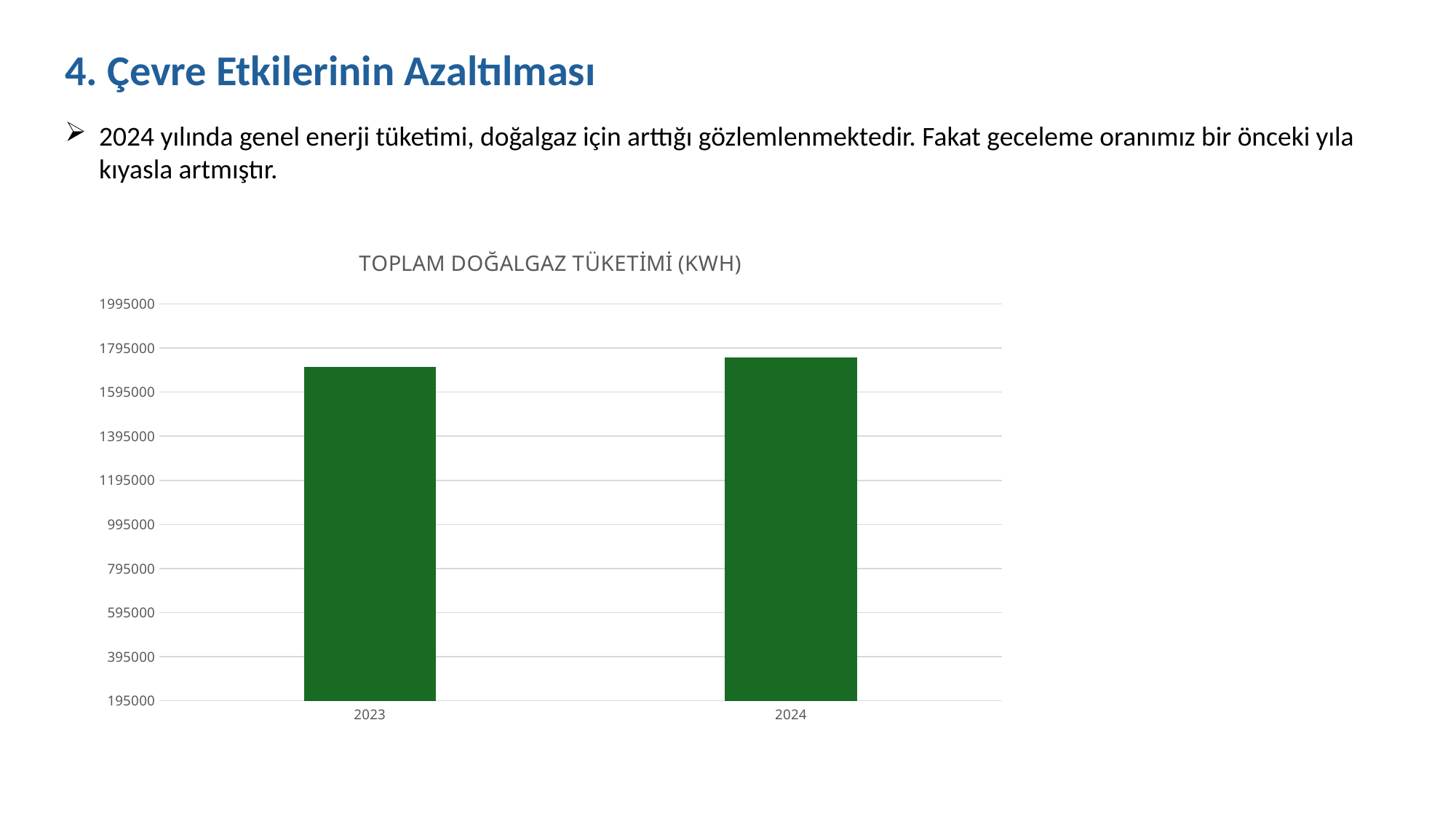
What type of chart is shown on the slide? bar chart How many categories (years) are shown on the x axis of the chart? 2 Is the value for 2023 greater or less than 1595000? greater Which year has the lower total natural gas consumption in the chart? 2023 Which year has the higher total natural gas consumption in the chart? 2024 Is the value for 2024 greater or less than 1995000? less What is the title of the chart? TOPLAM DOĞALGAZ TÜKETİMİ (KWH) Is the value for 2024 greater or less than 1595000? greater What colour are the bars in the chart? green Is the bar for 2024 taller or shorter than the bar for 2023? taller Does the total natural gas consumption rise or fall from 2023 to 2024? rise